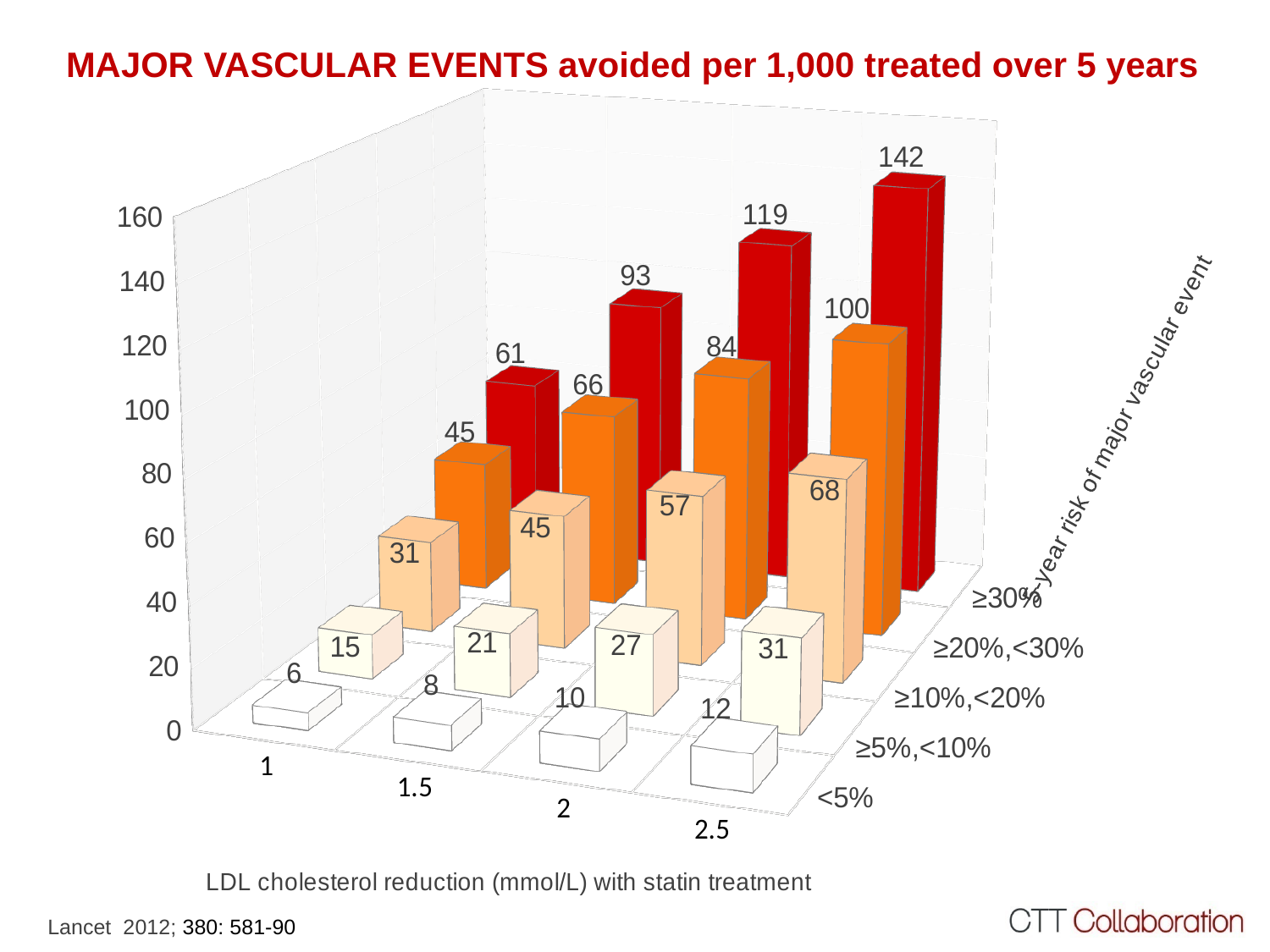
How many major vascular events are avoided per 1,000 treated for an LDL reduction of 2.5 mmol/L in the ≥30% risk group? 142 What kind of chart is shown on the slide? bar chart How many LDL cholesterol reduction levels are shown on the x axis? 4 Which combination of LDL reduction and risk group has the highest number of events avoided? 2.5 mmol/L, ≥30% What is the value for an LDL reduction of 2 mmol/L in the ≥10%,<20% risk group? 57 What is the value for an LDL reduction of 1 mmol/L in the <5% risk group? 6 Do the values rise or fall as LDL cholesterol reduction increases within each risk group? rise Which combination of LDL reduction and risk group has the lowest number of events avoided? 1 mmol/L, <5% Which is larger: the value for 2.5 mmol/L in the ≥20%,<30% group or the value for 2 mmol/L in the ≥30% group? 2 mmol/L in the ≥30% group What is the value for an LDL reduction of 1.5 mmol/L in the ≥20%,<30% risk group? 66 What is the difference between the values for 2.5 mmol/L and 1 mmol/L in the ≥30% risk group? 81 How many 5-year risk categories are shown on the chart? 5